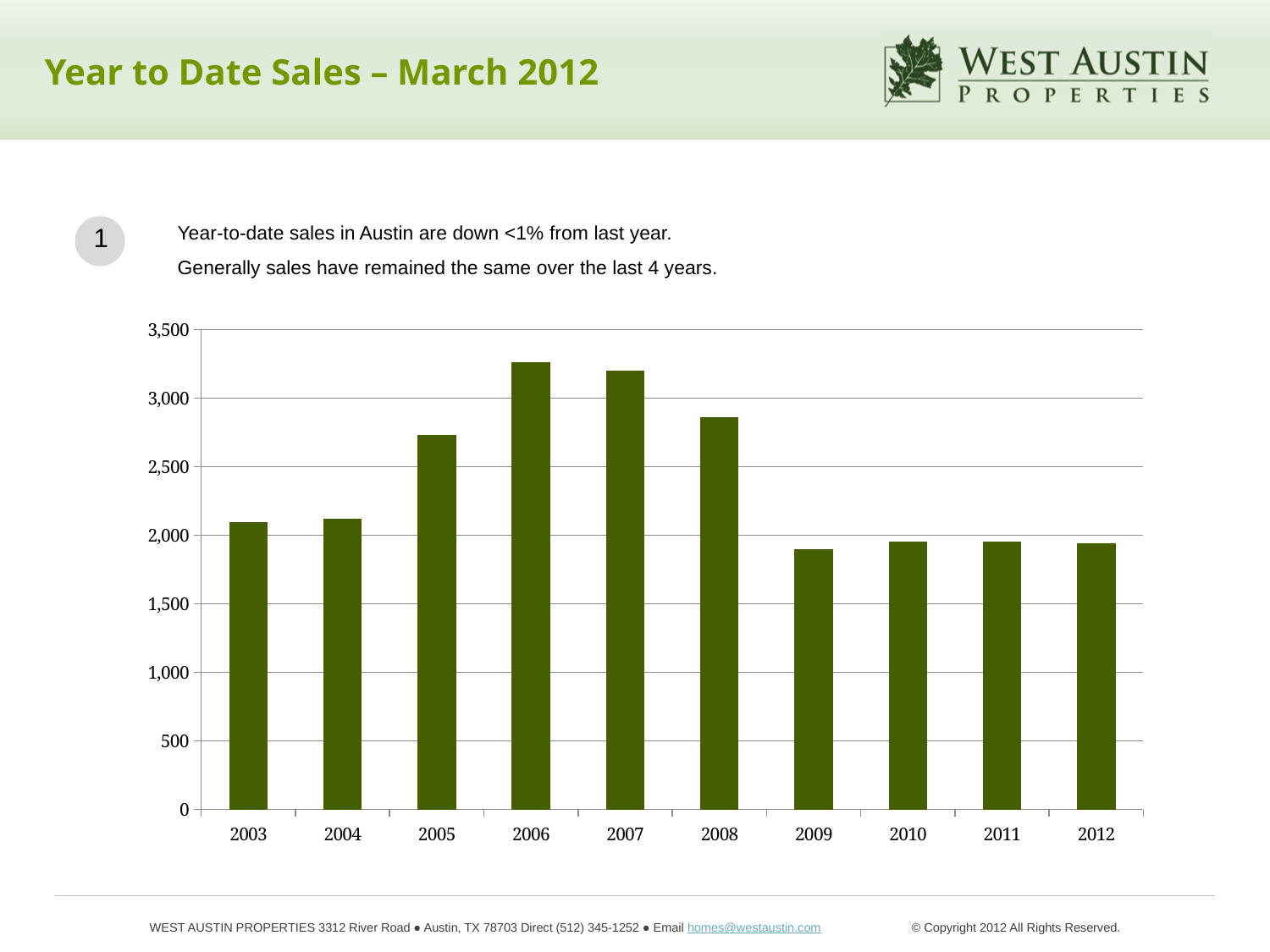
What is the highest value shown on the y axis of the chart? 3,500 Which year has the highest bar in the chart? 2006 Which year has the larger value, 2005 or 2008? 2008 Is the value for 2005 greater or less than 2,500? greater Do the values rise or fall from 2003 to 2006? rise What kind of chart is shown on the slide? bar chart Is the value for 2003 greater or less than 2,000? greater Is the value for 2008 greater or less than 3,000? less Which year has the larger value, 2003 or 2006? 2006 How many years are shown on the x axis of the chart? 10